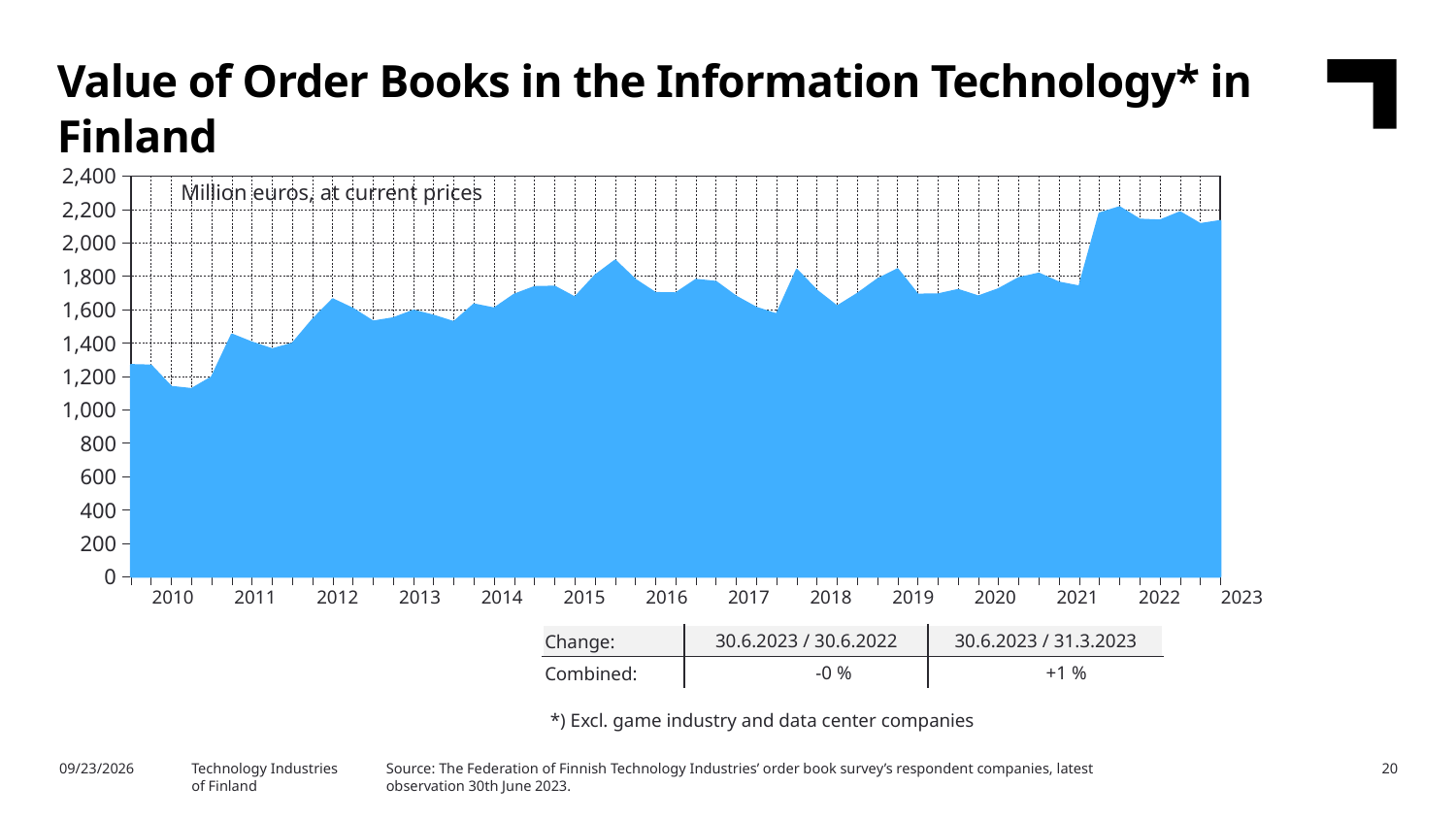
What kind of chart is shown on the slide? area chart Is the value of order books in 2022 greater or less than 2,000? greater What unit is stated in the label inside the chart area? Million euros, at current prices How many year labels are shown on the x axis? 14 What is the title of the chart? Value of Order Books in the Information Technology* in Finland Is the value of order books in 2015 greater or less than 1,600? greater Is the value of order books in 2020 greater or less than 2,000? less What is the highest value shown on the y axis? 2,400 Which is larger, the value of order books in 2010 or in 2022? 2022 Overall, do the values rise or fall from 2010 to 2023? rise